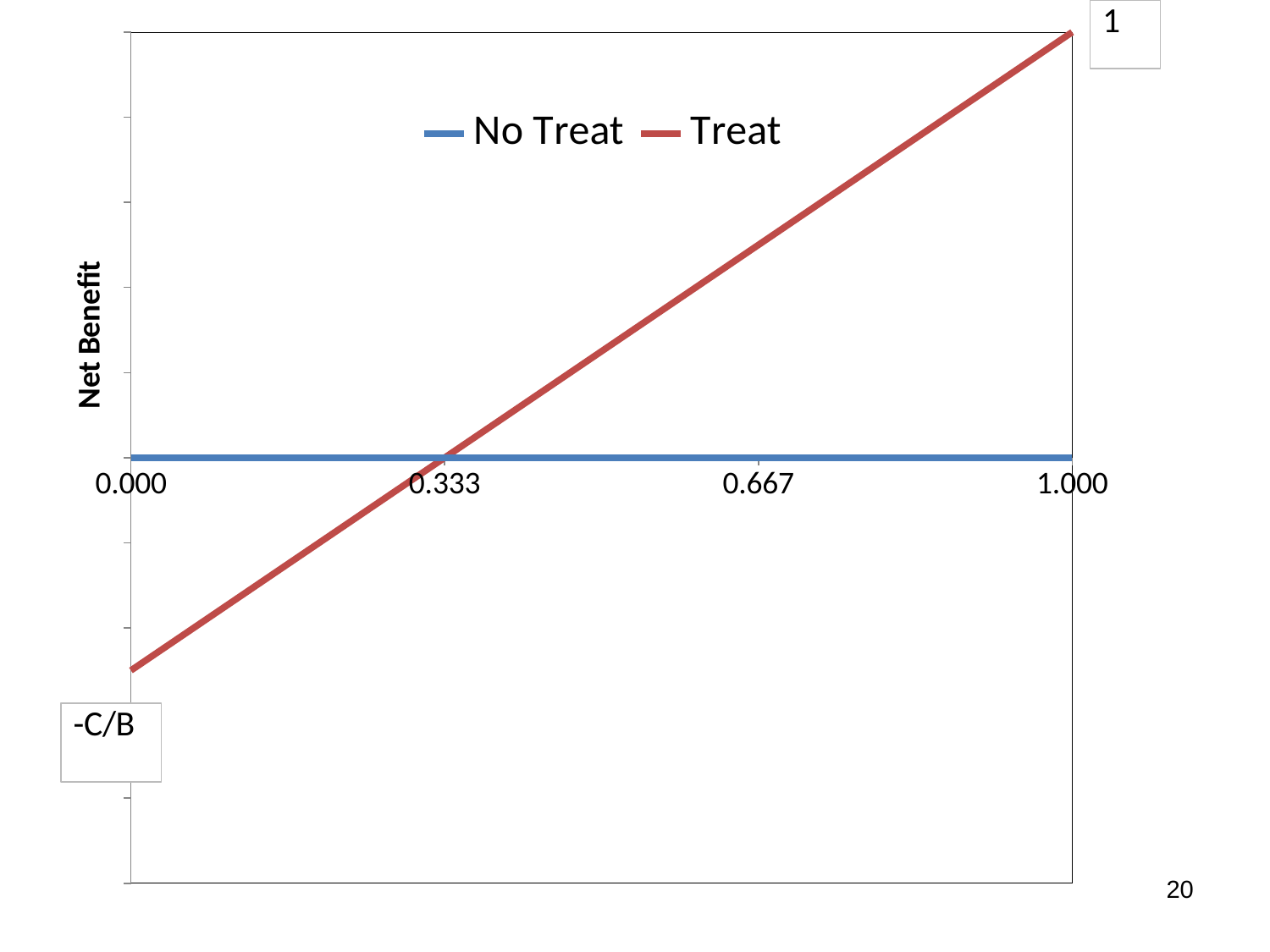
What are the two series named in the legend? No Treat and Treat How many series does the legend list? 2 What value is labelled at the right end of the Treat line, at x = 1.000? 1 At x = 0.000, which series has the higher Net Benefit, Treat or No Treat? No Treat What kind of chart is shown on the slide? line chart Does the Treat line rise or fall as the x-axis value increases from 0.000 to 1.000? rise At x = 1.000, which series has the higher Net Benefit, Treat or No Treat? Treat How many tick labels are shown on the x axis? 4 What is the label on the vertical axis? Net Benefit At which x-axis tick value does the Treat line cross the No Treat line? 0.333 What value is labelled at the left end of the Treat line, at x = 0.000? -C/B Does the No Treat line rise, fall, or stay flat across the x axis? stay flat